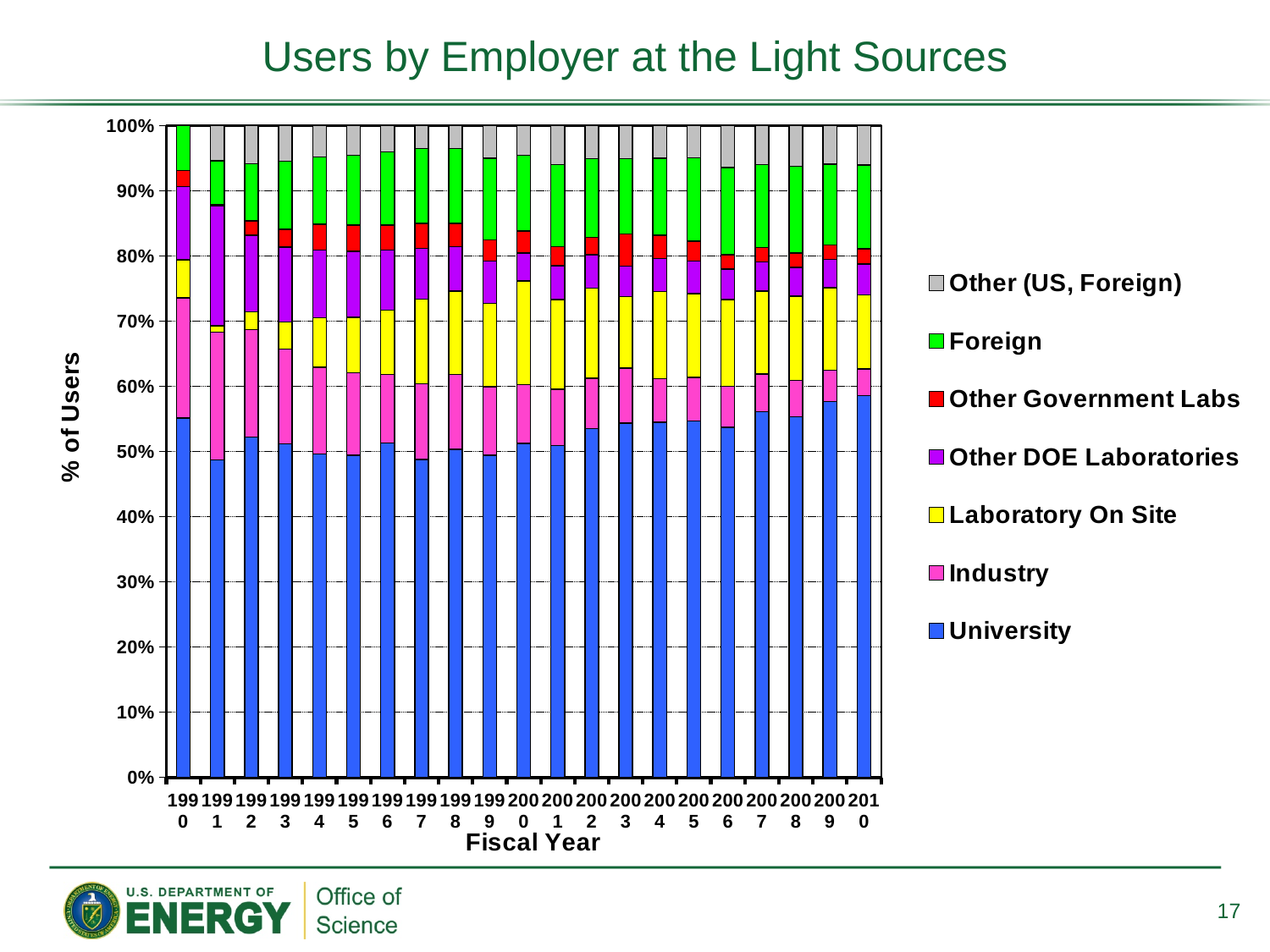
Which series is plotted at the bottom of each stacked bar? University Does the Industry share of users generally rise or fall from fiscal year 1990 to fiscal year 2010? fall Which is larger, the University share of users in fiscal year 2010 or in fiscal year 1991? 2010 What is the title of the chart? Users by Employer at the Light Sources Is the University share of users in fiscal year 2010 greater or less than 50%? greater Is the combined University and Industry share of users in fiscal year 1990 greater or less than 70%? greater Is the University share of users in fiscal year 1991 greater or less than 50%? less What is the total of the stacked bar for fiscal year 2000? 100% How many series does the legend list? 7 How many fiscal years (bars) are plotted on the x axis? 21 What kind of chart is shown on the slide? stacked bar chart